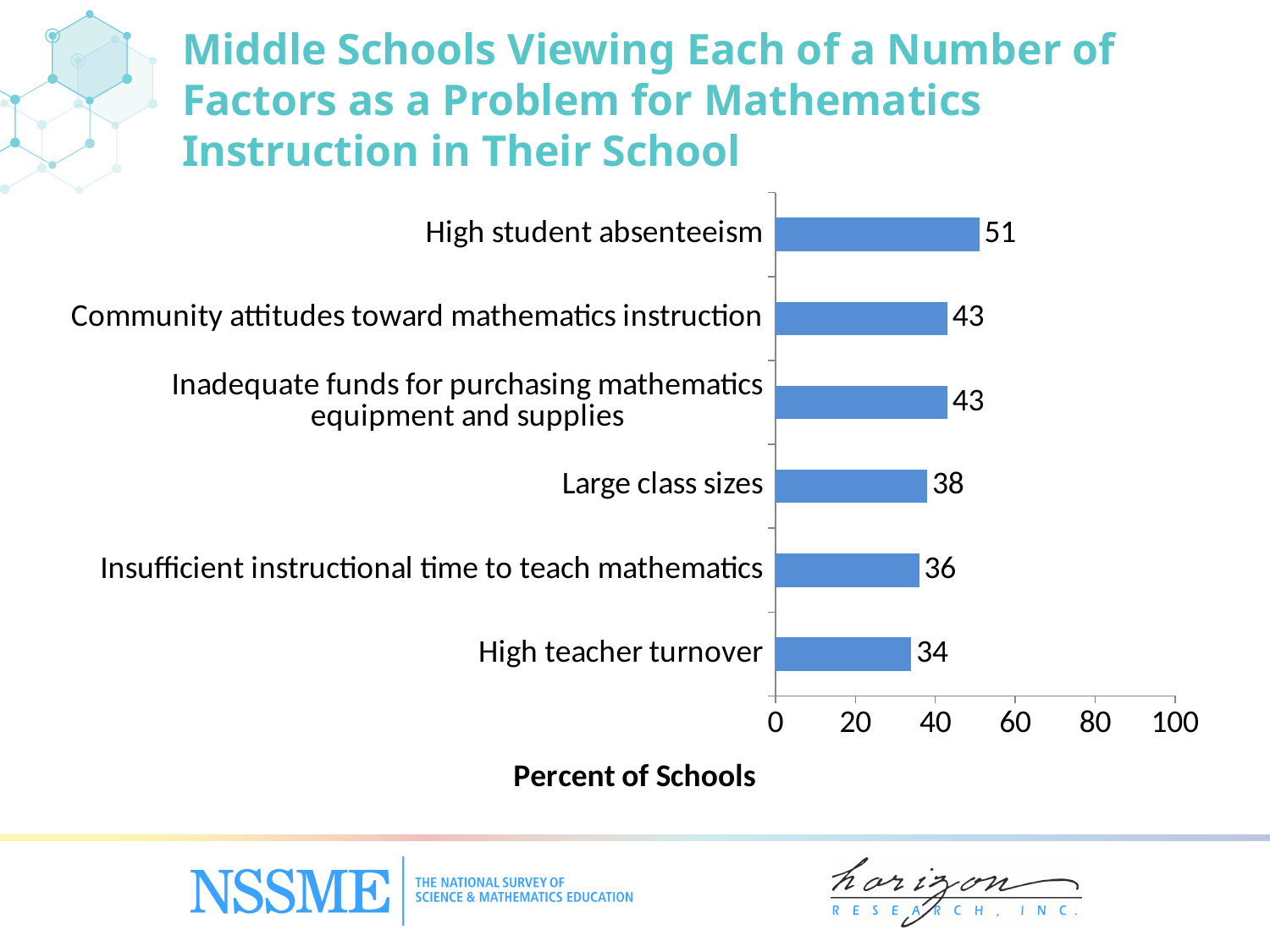
What is the difference between the values for community attitudes toward mathematics instruction and large class sizes? 5 Which is larger, the value for large class sizes or the value for insufficient instructional time to teach mathematics? Large class sizes Which factor has the highest percent of schools viewing it as a problem? High student absenteeism How many factors are shown in the chart? 6 What percent of schools view high student absenteeism as a problem for mathematics instruction? 51 What is the label of the horizontal axis? Percent of Schools What is the difference between the values for high student absenteeism and high teacher turnover? 17 What is the value for large class sizes? 38 What is the value for insufficient instructional time to teach mathematics? 36 What is the value for high teacher turnover? 34 What kind of chart is shown on the slide? Bar chart Which factor has the lowest percent of schools viewing it as a problem? High teacher turnover